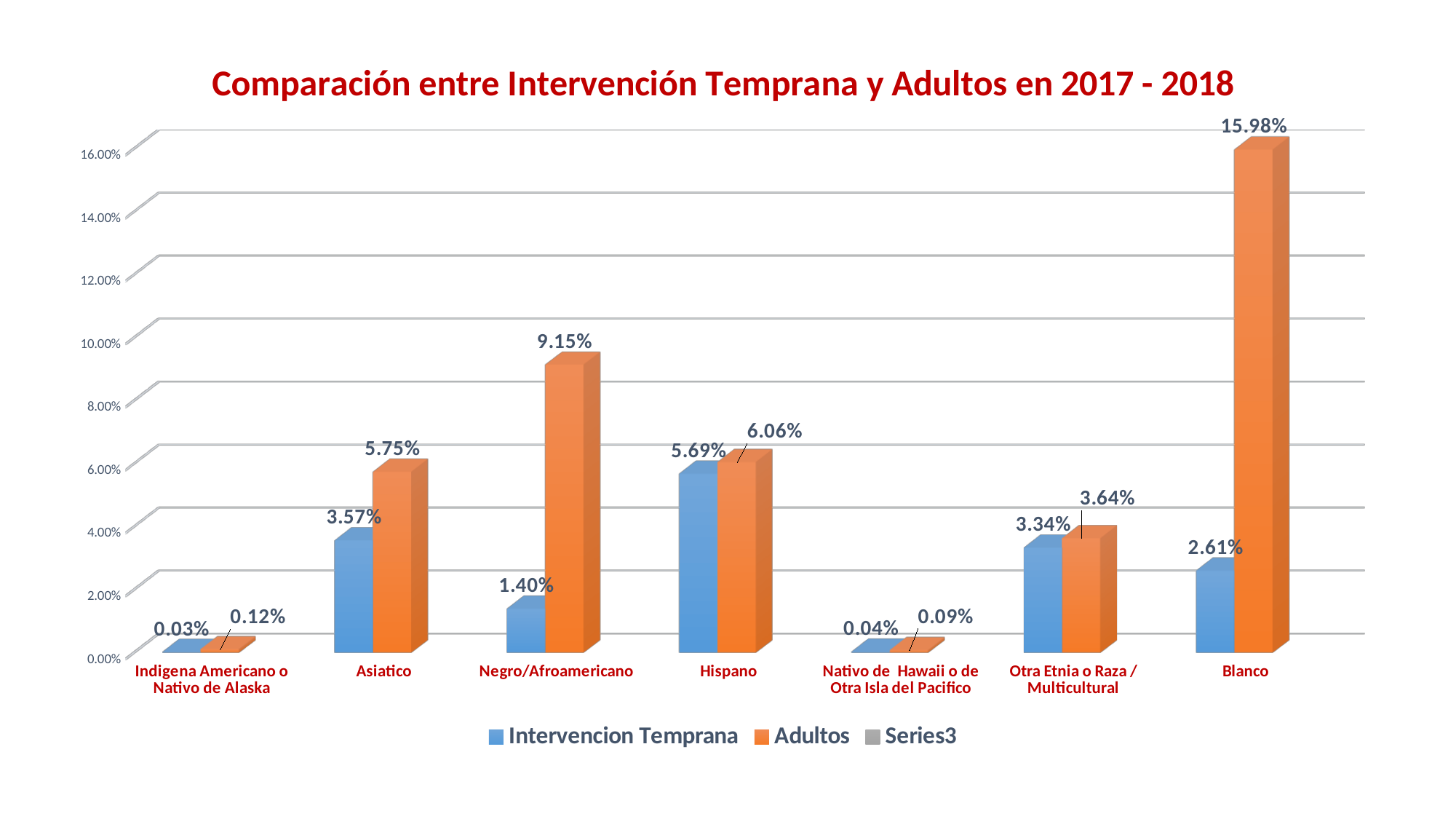
What is the title of the chart? Comparación entre Intervención Temprana y Adultos en 2017 - 2018 What is the Adultos value for Negro/Afroamericano? 9.15% What kind of chart is shown on the slide? Bar chart What is the Adultos value for Blanco? 15.98% Which is larger for Otra Etnia o Raza / Multicultural: the Intervencion Temprana value or the Adultos value? Adultos What is the Intervencion Temprana value for Asiatico? 3.57% What is the difference between the Adultos and Intervencion Temprana values for Blanco? 13.37% Which category has the lowest Intervencion Temprana value? Indigena Americano o Nativo de Alaska How many series does the legend list? 3 What is the Intervencion Temprana value for Hispano? 5.69% Which category has the highest Adultos value? Blanco How many categories are shown on the x axis? 7